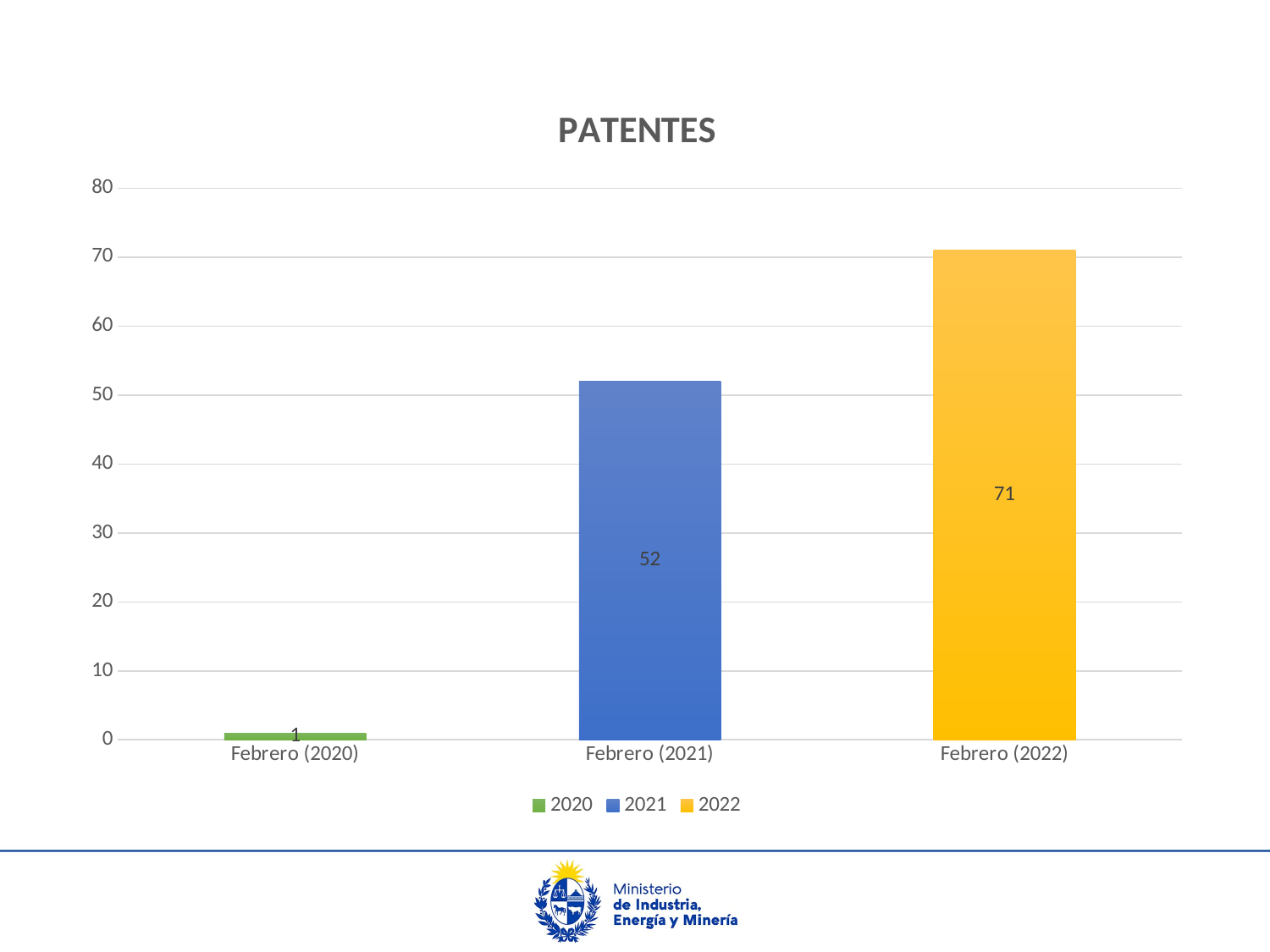
How many entries does the legend of the PATENTES chart list? 3 Is the value for Febrero (2022) greater or less than 60? greater What is the value for Febrero (2020) in the PATENTES chart? 1 What is the difference between the values for Febrero (2021) and Febrero (2020)? 51 Which category has the lowest value in the PATENTES chart? Febrero (2020) What kind of chart is shown on the slide? Bar chart What is the difference between the values for Febrero (2022) and Febrero (2021)? 19 What is the value for Febrero (2022) in the PATENTES chart? 71 What is the value for Febrero (2021) in the PATENTES chart? 52 How many categories are shown on the x axis of the PATENTES chart? 3 Which is larger, the value for Febrero (2021) or Febrero (2022)? Febrero (2022) Which category has the highest value in the PATENTES chart? Febrero (2022)